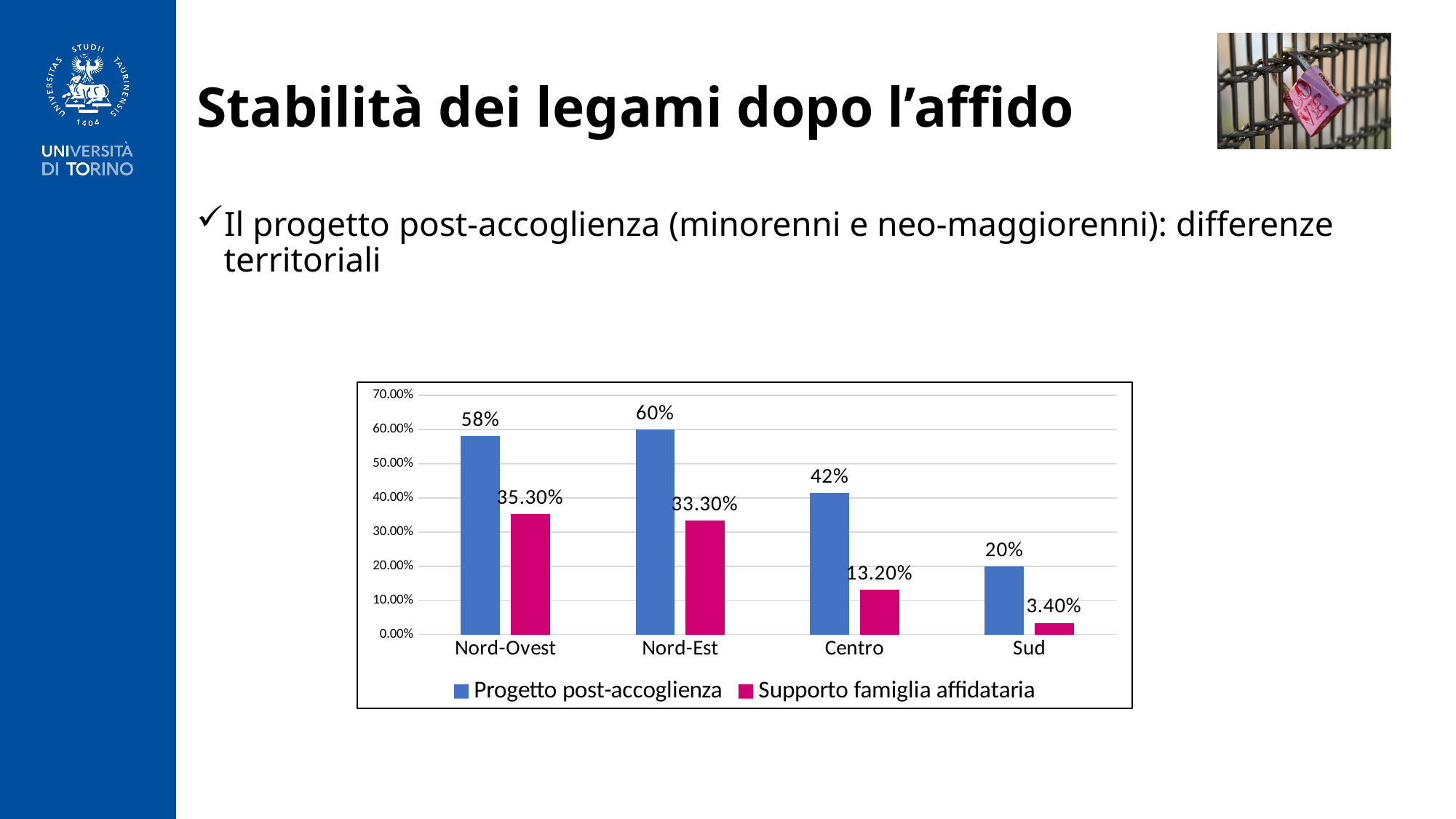
What is the difference between Progetto post-accoglienza and Supporto famiglia affidataria in Centro? 28.80% How many series does the legend list? 2 What kind of chart is shown on the slide? Bar chart Which region has the lowest value for Supporto famiglia affidataria? Sud What is the value for Supporto famiglia affidataria in Sud? 3.40% Which is larger in Nord-Ovest: Progetto post-accoglienza or Supporto famiglia affidataria? Progetto post-accoglienza Do the values for Supporto famiglia affidataria rise or fall from Nord-Ovest to Sud? Fall What is the value for Supporto famiglia affidataria in Nord-Ovest? 35.30% What is the value for Progetto post-accoglienza in Centro? 42% How many regions are shown on the x axis? 4 Which region has the highest value for Progetto post-accoglienza? Nord-Est What is the value for Progetto post-accoglienza in Nord-Est? 60%